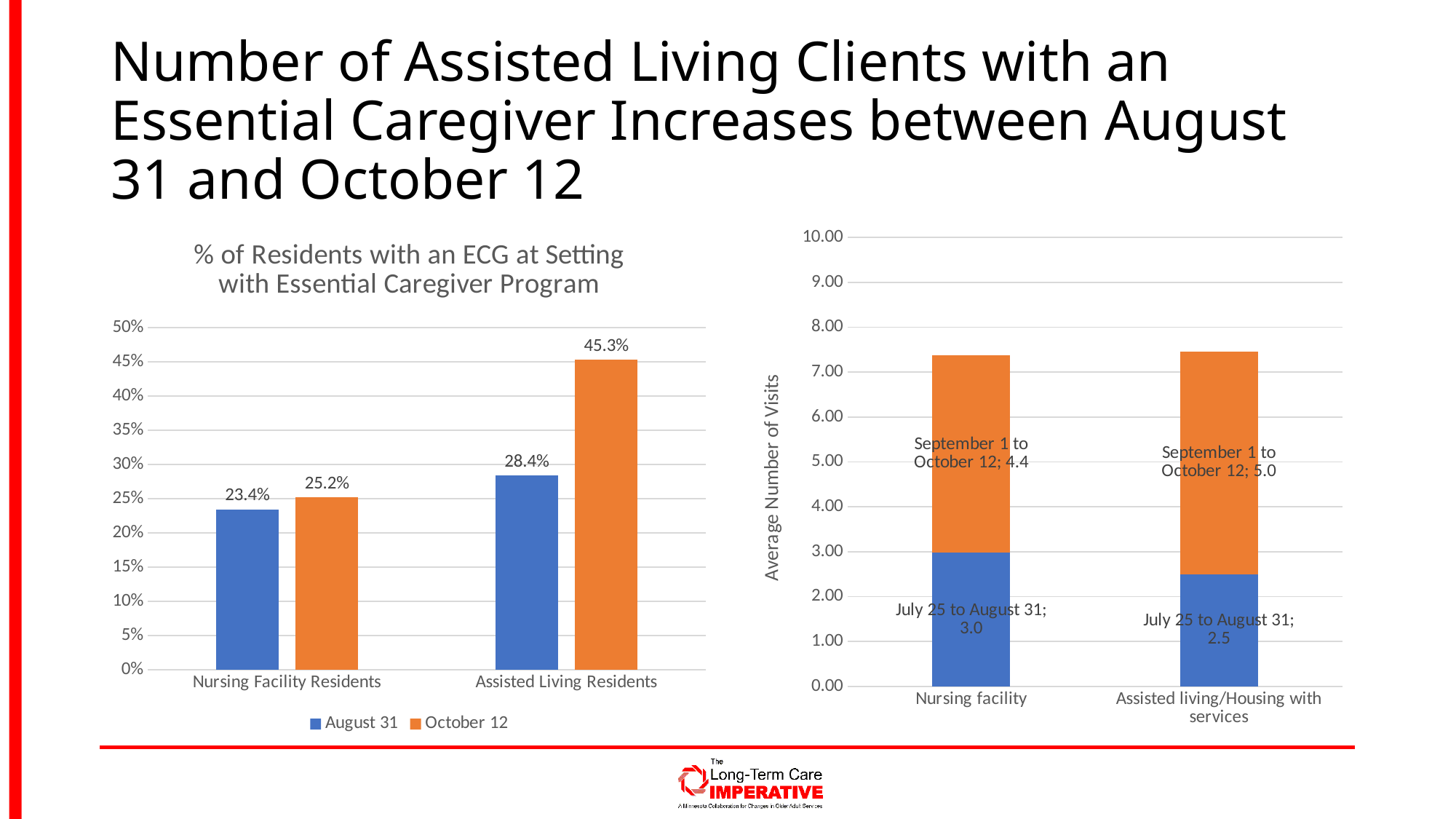
In the left chart, is the August 31 value for Assisted Living Residents greater or less than the October 12 value for Nursing Facility Residents? greater In the left chart, what is the August 31 value for Nursing Facility Residents? 23.4% In the right chart (Average Number of Visits), what is the value for July 25 to August 31 for Nursing facility? 3.0 In the right chart, what is the value for September 1 to October 12 for Assisted living/Housing with services? 5.0 In the right chart, what is the total of the stacked bar for Nursing facility? 7.4 What kind of chart is the right chart? Stacked bar chart In the left chart, how many series does the legend list? 2 In the right chart, what is the total of the stacked bar for Assisted living/Housing with services? 7.5 In the left chart, what is the October 12 value for Nursing Facility Residents? 25.2% In the left chart titled '% of Residents with an ECG at Setting with Essential Caregiver Program', what is the October 12 value for Assisted Living Residents? 45.3% In the left chart, what is the difference between the October 12 and August 31 values for Assisted Living Residents? 16.9% In the left chart, which category has the highest October 12 value? Assisted Living Residents